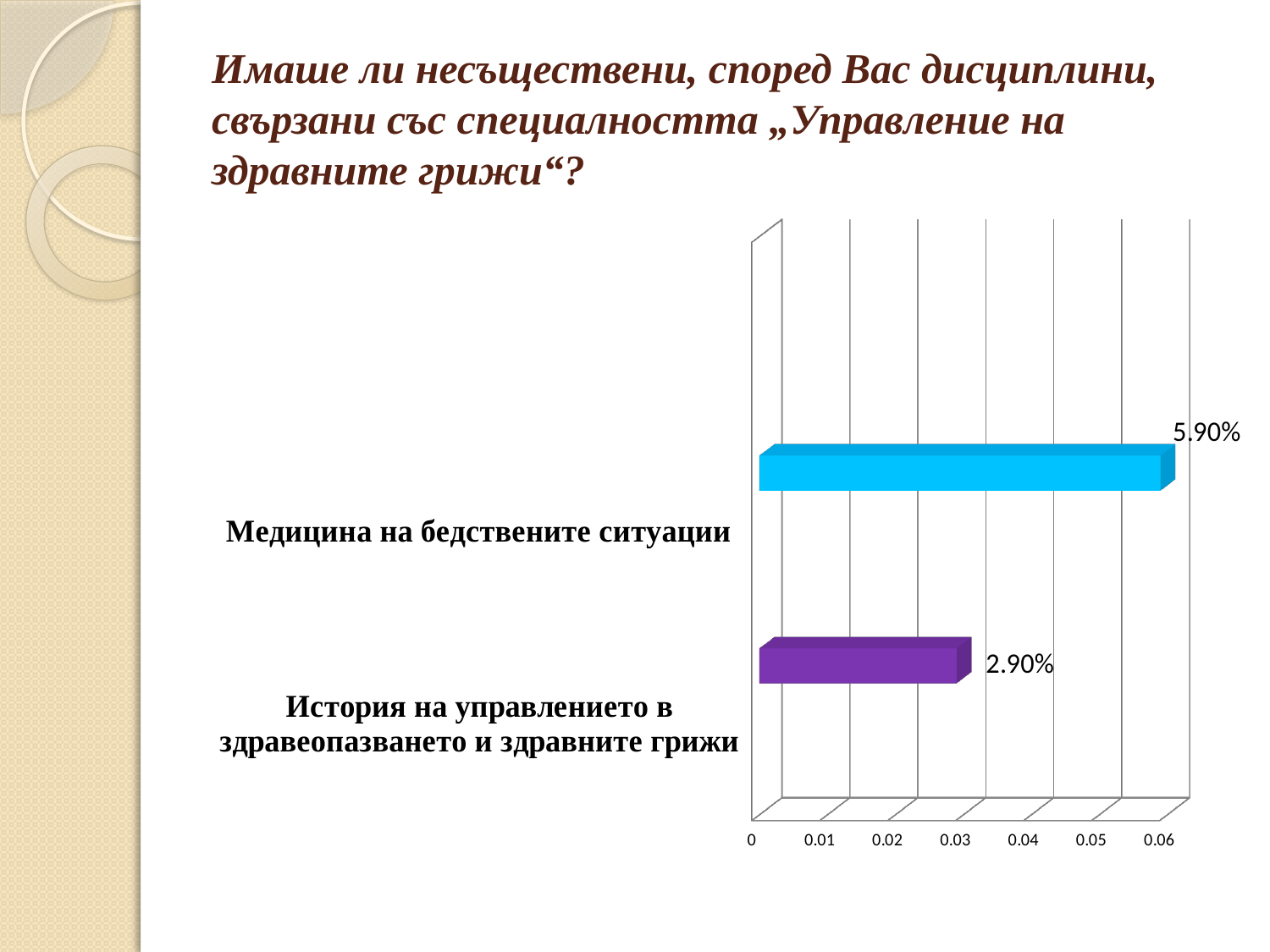
Is the value for "История на управлението в здравеопазването и здравните грижи" greater or less than 0.04? less What is the difference between the values for "Медицина на бедствените ситуации" and "История на управлението в здравеопазването и здравните грижи"? 3.00% What is the value for "Медицина на бедствените ситуации"? 5.90% What colour is the bar for "Медицина на бедствените ситуации"? blue How many categories are shown in the chart? 2 What is the highest tick value shown on the horizontal axis? 0.06 What kind of chart is shown on the slide? bar chart What is the value for "История на управлението в здравеопазването и здравните грижи"? 2.90% Is the value for "Медицина на бедствените ситуации" greater or less than 0.05? greater Which category has the lowest value? История на управлението в здравеопазването и здравните грижи Which category has the highest value? Медицина на бедствените ситуации Which is larger: the value for "Медицина на бедствените ситуации" or the value for "История на управлението в здравеопазването и здравните грижи"? Медицина на бедствените ситуации